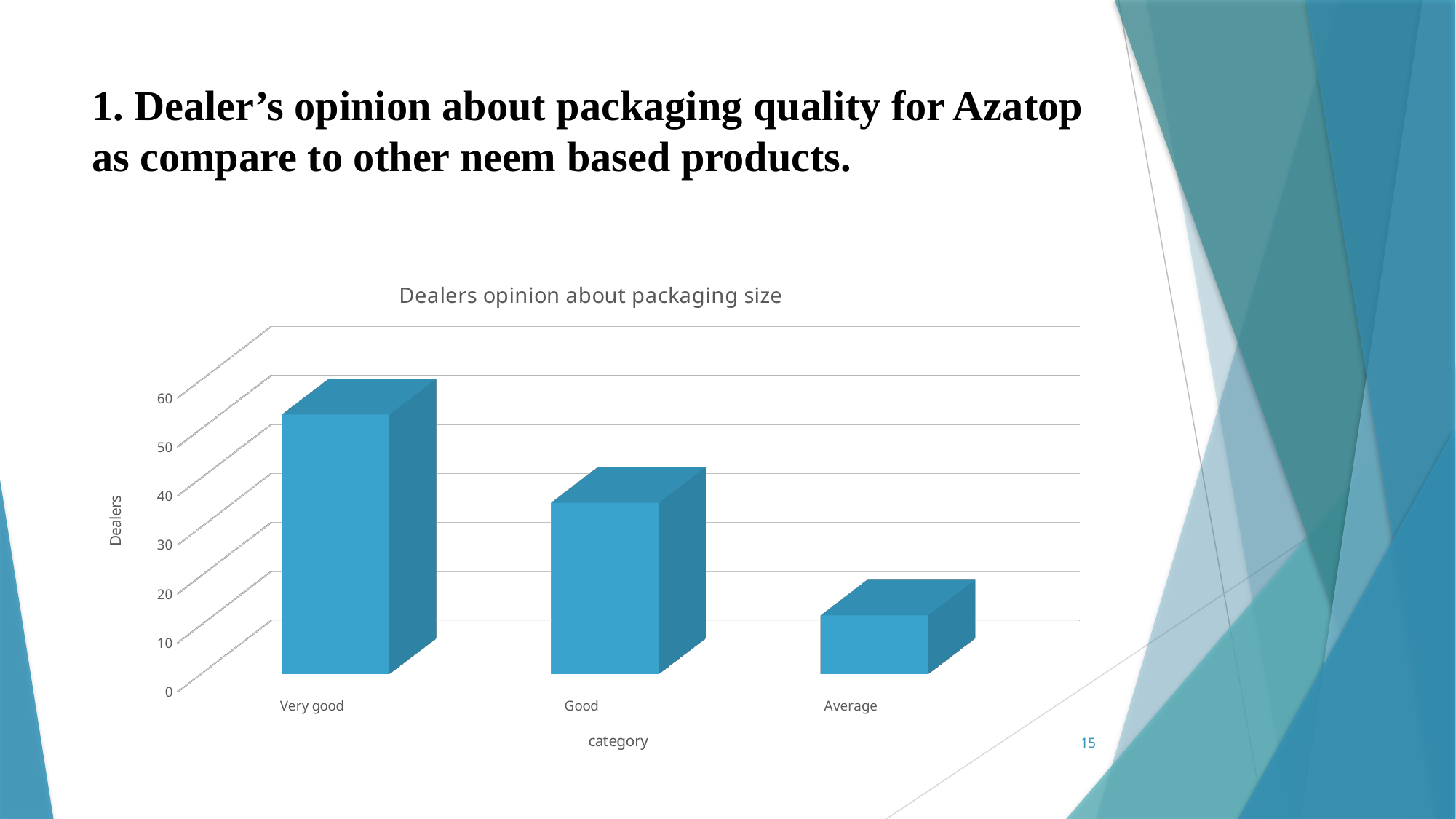
Is the value for Average greater or less than 30? less Which is larger, the value for Very good or the value for Good? Very good Which category has the highest number of dealers? Very good Is the value for Very good greater or less than 40? greater What kind of chart is shown on the slide? bar chart Which category has the lowest number of dealers? Average What is the label of the vertical axis of the chart? Dealers How many categories are shown on the x axis of the chart? 3 What is the title of the chart? Dealers opinion about packaging size Is the value for Good greater or less than 30? greater Which is larger, the value for Good or the value for Average? Good Do the values rise or fall moving from Very good to Average along the x axis? fall